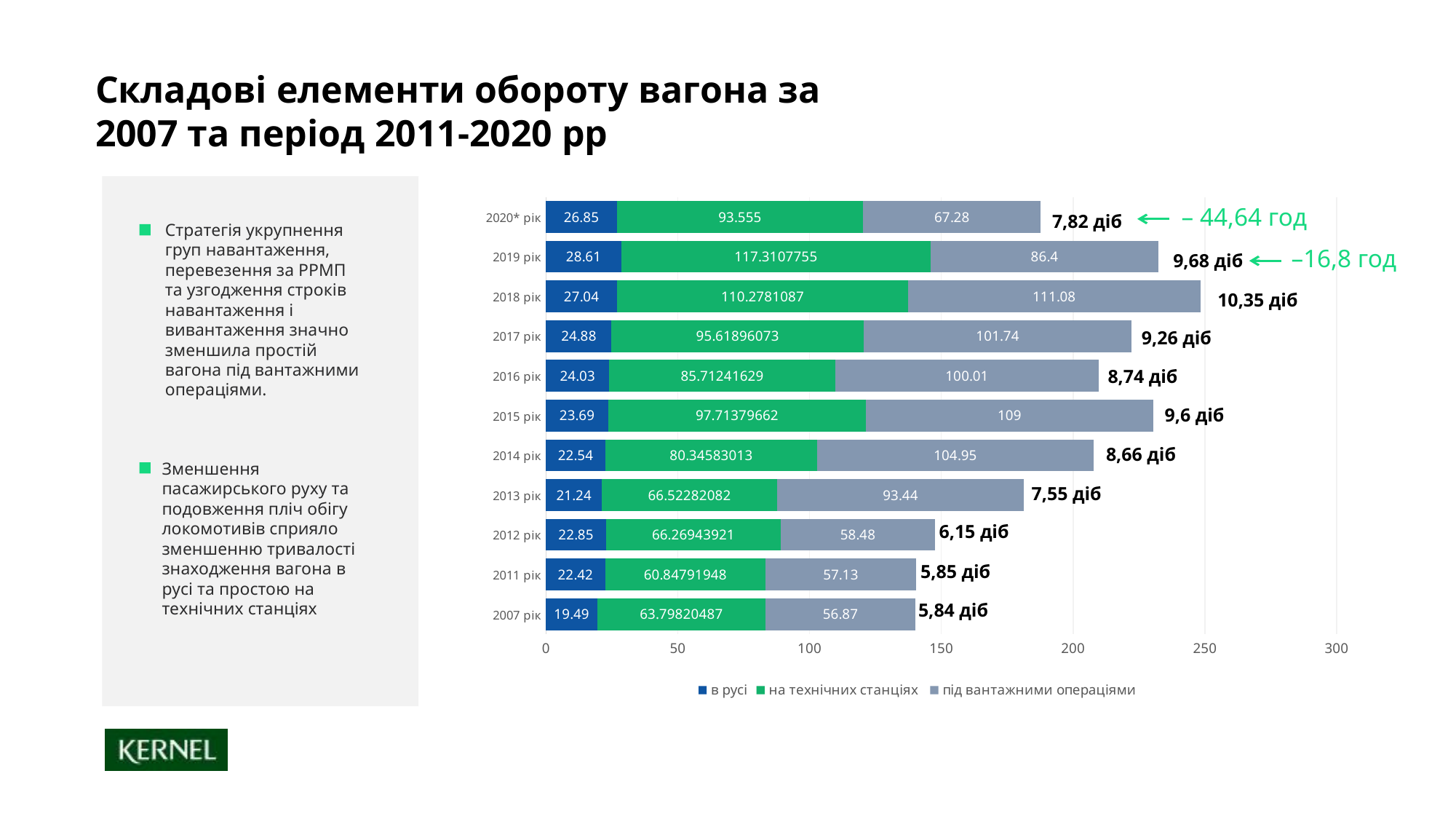
What is the value of the 'під вантажними операціями' segment for 2018 рік? 111.08 What is the value of the 'на технічних станціях' segment for 2020* рік? 93.555 What is the value of the 'в русі' segment for 2007 рік? 19.49 What kind of chart is shown on the slide? Stacked bar chart What is the total of the stacked bar for 2020* рік? 187.685 Which year has the lowest value for 'в русі'? 2007 рік What is the difference between the 'в русі' values for 2019 рік and 2020* рік? 1.76 How many years (categories) are shown on the chart? 11 What total in days is annotated next to the bar for 2020* рік? 7,82 діб Which year has the larger 'під вантажними операціями' value, 2013 рік or 2014 рік? 2014 рік Which year has the highest value for 'в русі'? 2019 рік How many series does the legend list? 3